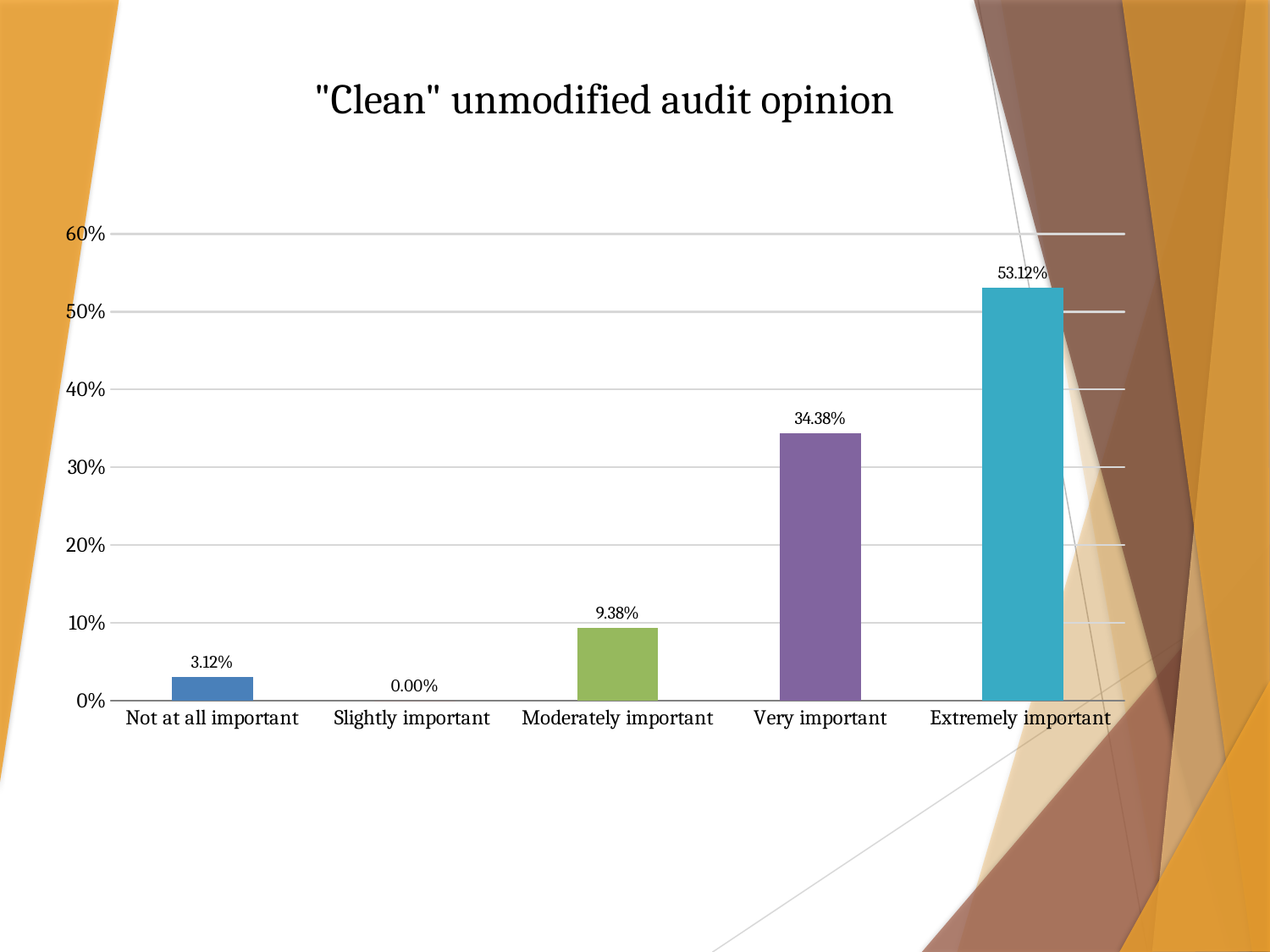
What kind of chart is shown on the slide? bar chart What is the value for Very important? 34.38% Which category has the lowest value? Slightly important Is the value for Very important greater or less than 30%? greater What is the value for Moderately important? 9.38% What is the value for Slightly important? 0.00% What is the value for Extremely important? 53.12% How many categories are shown on the x axis? 5 Which is larger, the value for Moderately important or the value for Not at all important? Moderately important What is the title of the chart? "Clean" unmodified audit opinion What is the difference between the values for Extremely important and Very important? 18.74% Which category has the highest value? Extremely important